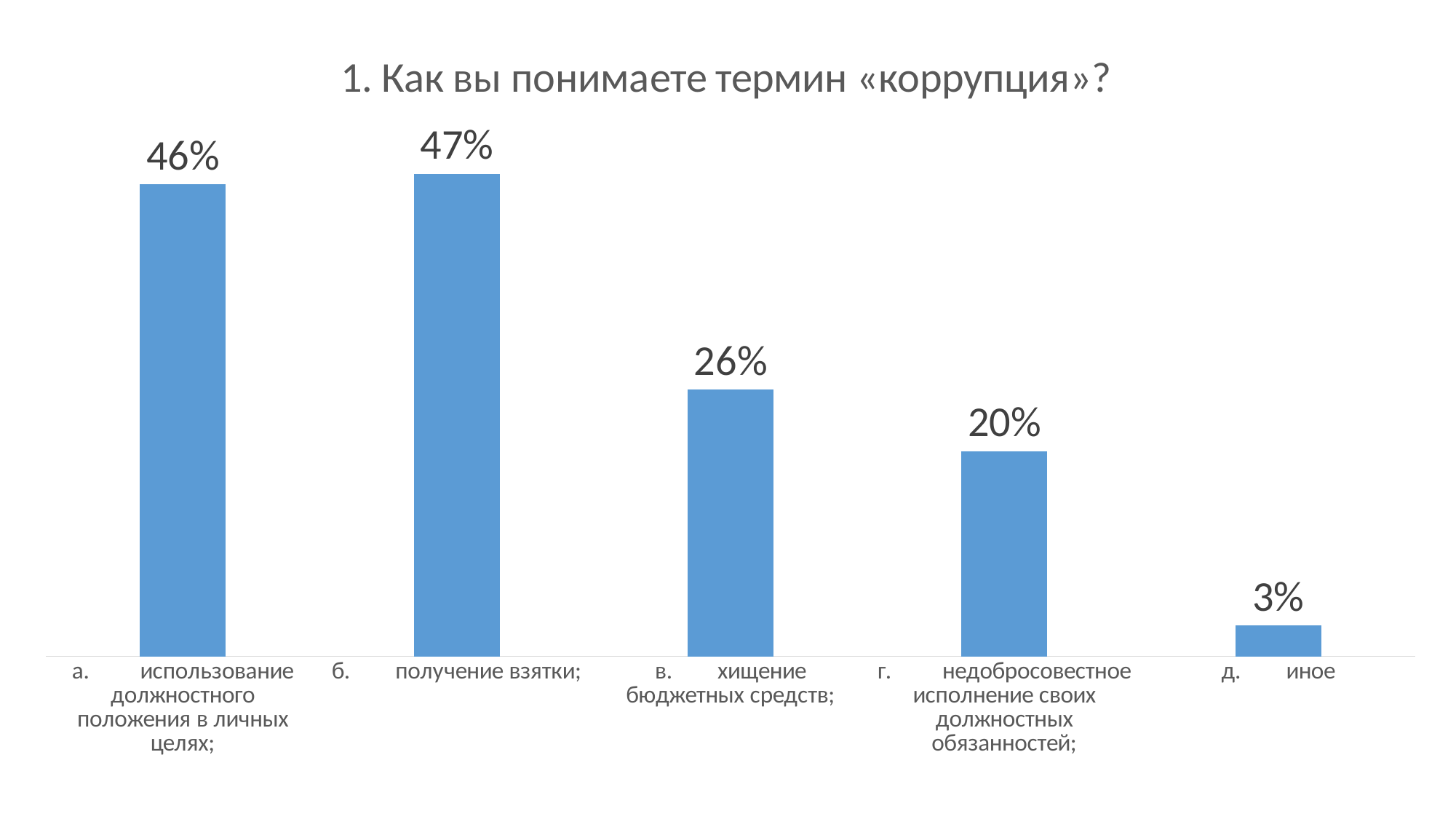
What kind of chart is shown on the slide? bar chart What is the value for "получение взятки"? 47% What is the title of the chart? 1. Как вы понимаете термин «коррупция»? Which category has the highest value? получение взятки What is the value for "хищение бюджетных средств"? 26% What is the difference between the values for "получение взятки" and "хищение бюджетных средств"? 21% How many categories are shown in the chart? 5 What is the value for "иное"? 3% Which is larger: the value for "хищение бюджетных средств" or the value for "недобросовестное исполнение своих должностных обязанностей"? хищение бюджетных средств What is the difference between the values for "использование должностного положения в личных целях" and "иное"? 43% Which category has the lowest value? иное What is the value for "недобросовестное исполнение своих должностных обязанностей"? 20%